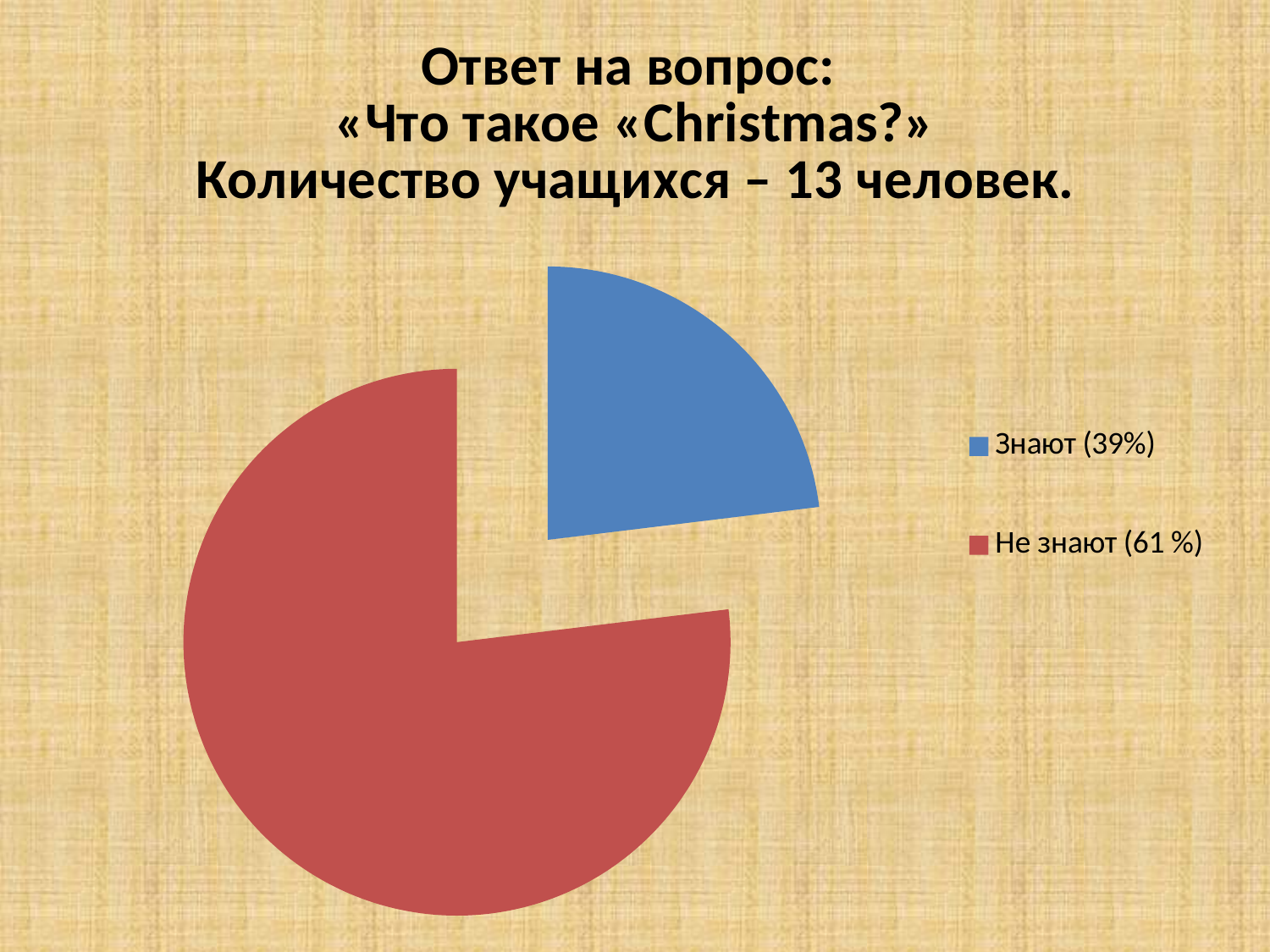
Which slice is the largest? Не знают What percentage is shown for the "Знают" slice? 39% What is the difference in percentage points between the "Не знают" and "Знают" slices? 22 What colour is the "Не знают" slice? red How many slices does the pie chart have? 2 What percentage is shown for the "Не знают" slice? 61 % What colour is the "Знают" slice? blue Which slice is the smallest? Знают How many entries does the legend list? 2 What kind of chart is shown on the slide? pie chart Which is larger, the "Знают" slice or the "Не знают" slice? Не знают How many students does the slide title say took part? 13